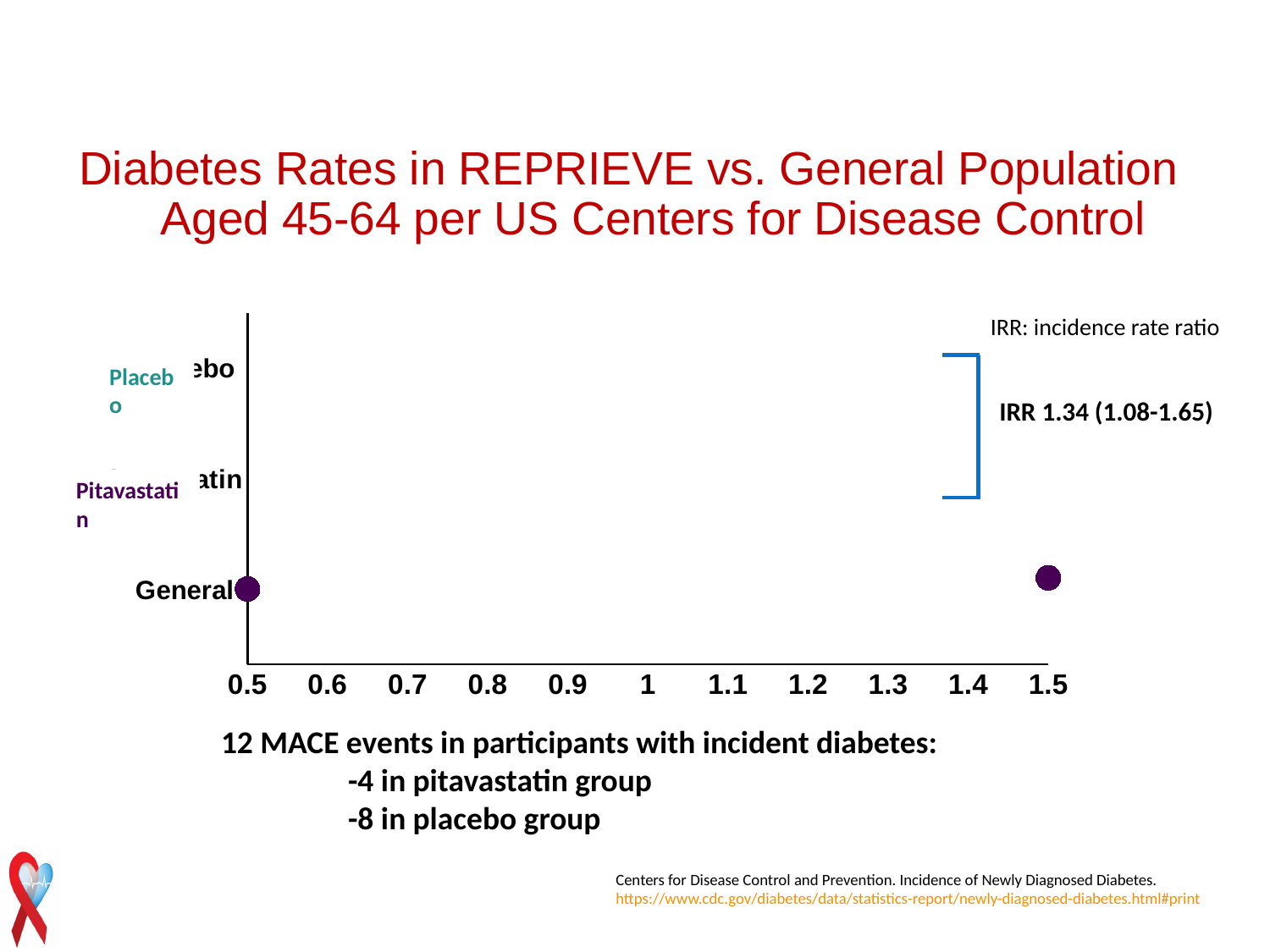
Is the lower bound of the IRR confidence interval shown on the chart greater or less than 1? greater Which three categories are labelled on the vertical axis of the chart? Placebo, Pitavastatin, General What is the lowest tick value shown on the horizontal axis of the chart? 0.5 Is the upper bound of the IRR confidence interval shown on the chart greater or less than 1.5? greater What is the highest tick value shown on the horizontal axis of the chart? 1.5 What kind of chart is shown on the slide? dot (scatter) chart How many tick labels are printed along the horizontal axis of the chart? 11 How many data points (dots) are plotted on the chart? 2 According to the chart annotation, what does IRR stand for? incidence rate ratio What IRR value is annotated on the chart? IRR 1.34 (1.08-1.65) How many category labels are listed along the vertical axis of the chart? 3 What is the title of the chart on the slide? Diabetes Rates in REPRIEVE vs. General Population Aged 45-64 per US Centers for Disease Control